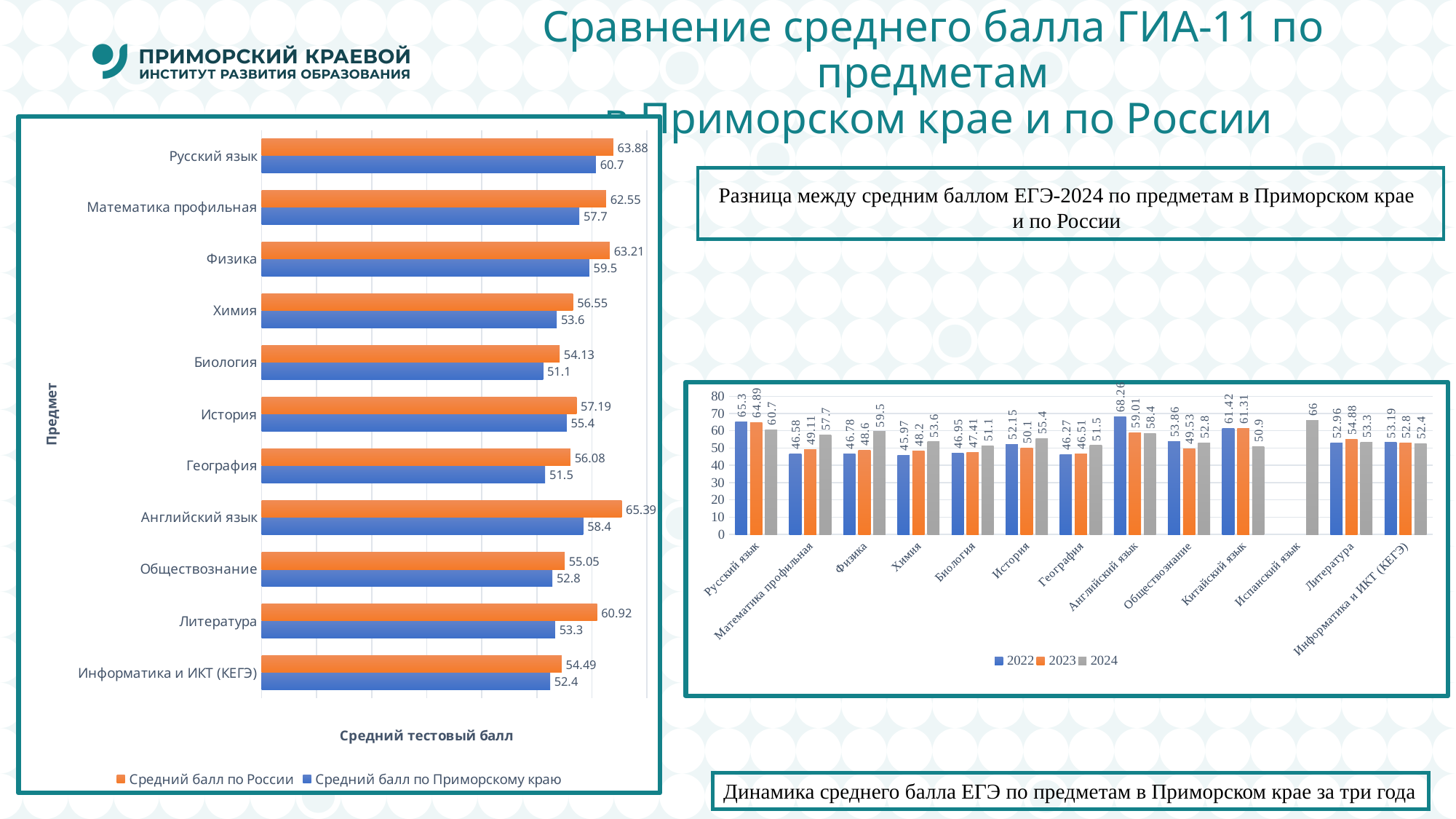
On the right chart (Динамика среднего балла ЕГЭ), how many series does the legend list? 3 On the right chart (Динамика среднего балла ЕГЭ), which is larger for Математика профильная: the 2022 value or the 2024 value? 2024 On the left chart, which subject has the highest average score for Russia? Английский язык On the left chart, what is the average score for Приморский край in Английский язык? 58.4 On the left chart, what is the average score for Russia (Средний балл по России) in Русский язык? 63.88 On the right chart (Динамика среднего балла ЕГЭ), what is the 2022 value for Английский язык? 68.26 On the left chart, what is the difference between the Russia score and the Приморский край score for Литература? 7.62 On the left chart, how many series does the legend list? 2 On the right chart (Динамика среднего балла ЕГЭ), what is the difference between the 2023 and 2024 values for Китайский язык? 10.41 On the left chart, which subject has the lowest average score for Приморский край? Биология On the left chart, how many subjects are listed? 11 What type of chart is the left chart? Bar chart